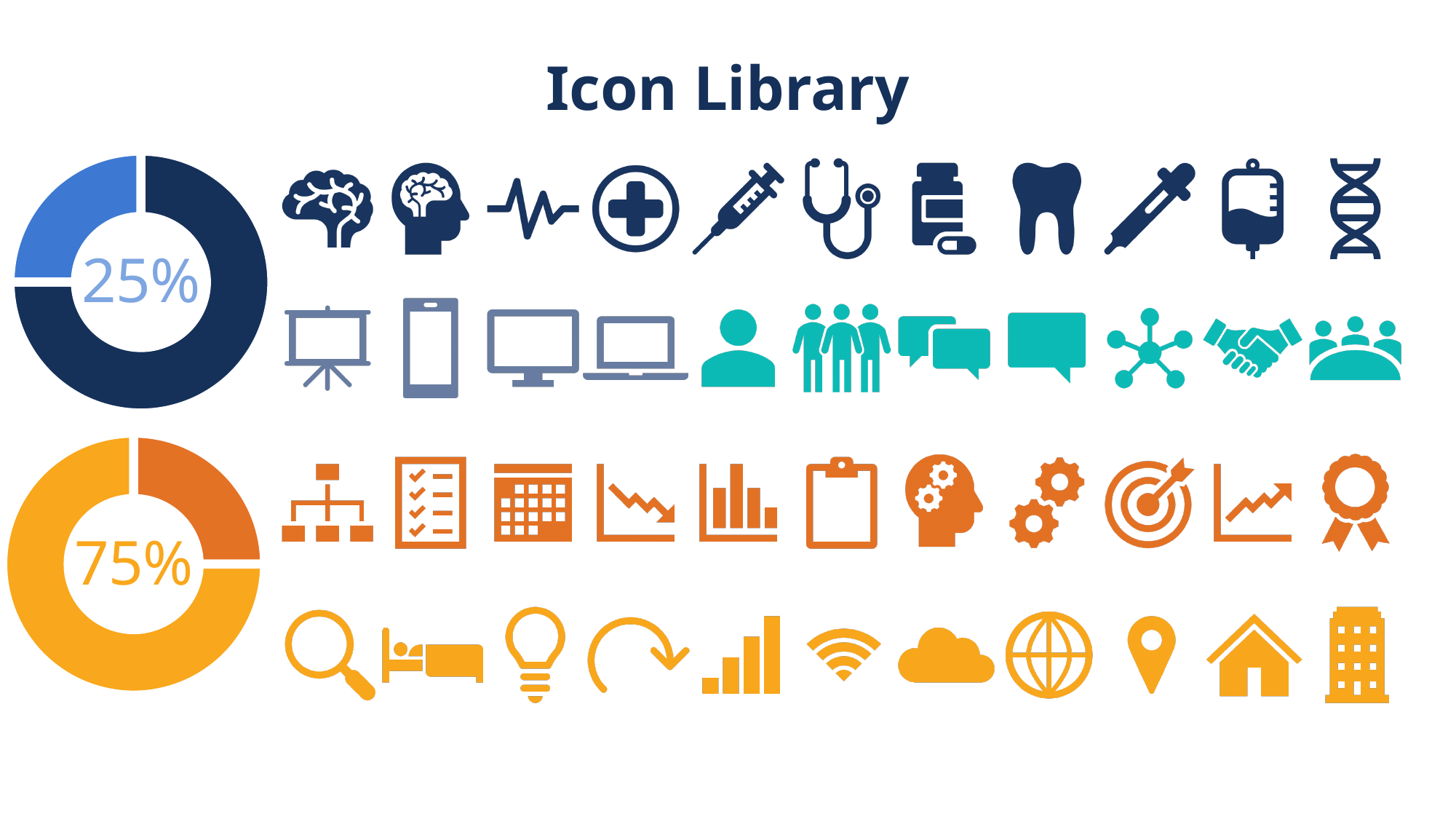
What is the difference between the percentage shown in the bottom-left donut chart and the percentage shown in the top-left donut chart? 50% What percentage is printed in the centre of the top-left donut chart? 25% What is the title of the slide containing the two donut charts? Icon Library What two colours are used for the slices of the bottom-left donut chart? Orange and yellow Which donut chart displays the larger percentage, the top-left one or the bottom-left one? The bottom-left one (75%) What kind of chart is shown at the bottom left of the slide? Donut (pie) chart What percentage is printed in the centre of the bottom-left donut chart? 75% What kind of chart is shown at the top left of the slide? Donut (pie) chart How many slices does the top-left donut chart have? 2 How many slices does the bottom-left donut chart have? 2